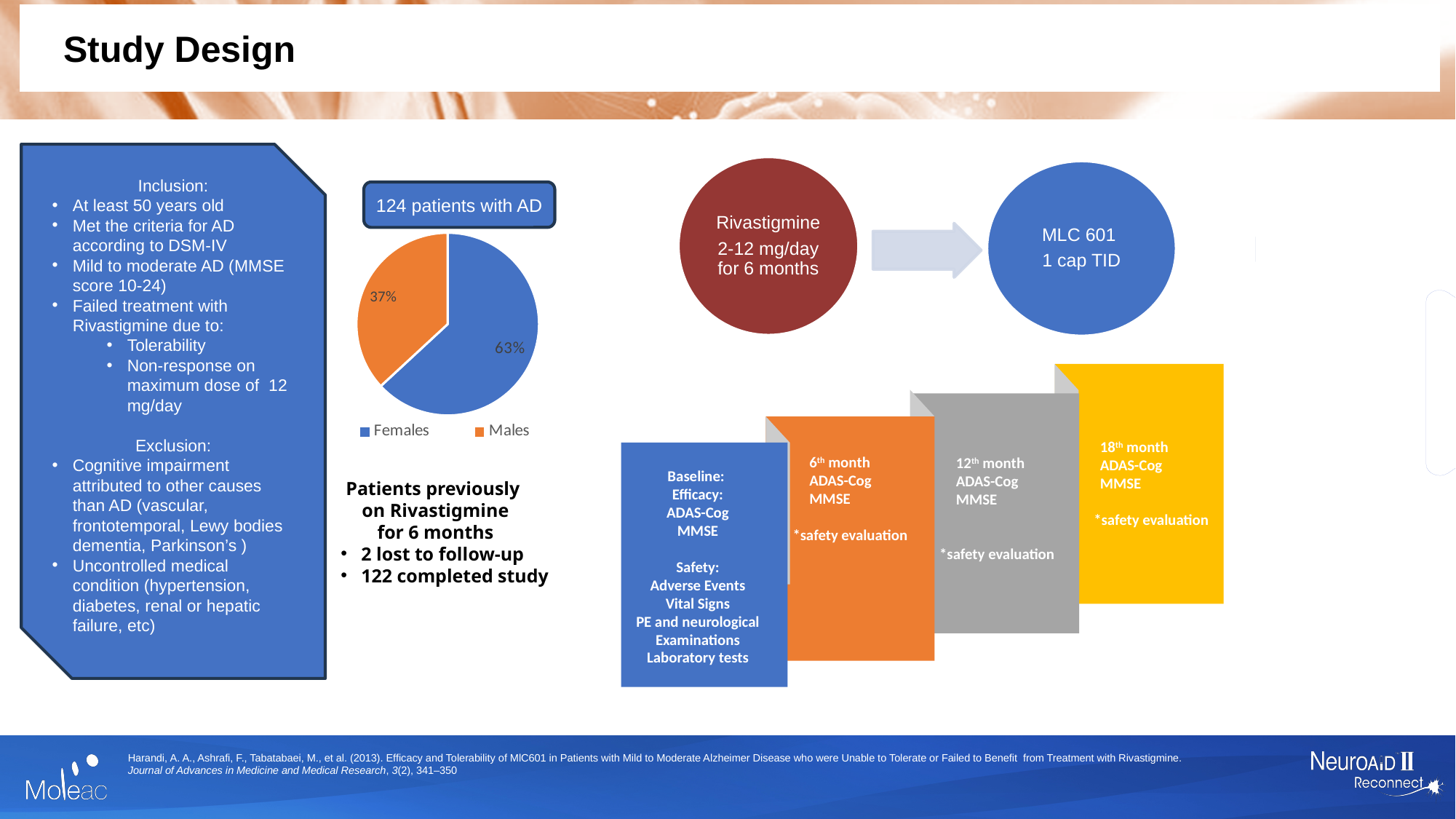
What is the difference in percentage points between the Females and Males slices? 26 How many entries does the legend of the pie chart list? 2 What percentage of the patients are Males? 37% Which group has the larger share of the pie, Females or Males? Females What colour is the Males slice in the pie chart? orange Which category has the largest slice of the pie? Females How many slices does the pie chart have? 2 What percentage of the patients are Females? 63% Which category has the smallest slice of the pie? Males Is the share for Females greater or less than 50%? greater What kind of chart is shown on the slide? pie chart What is the title shown above the pie chart? 124 patients with AD